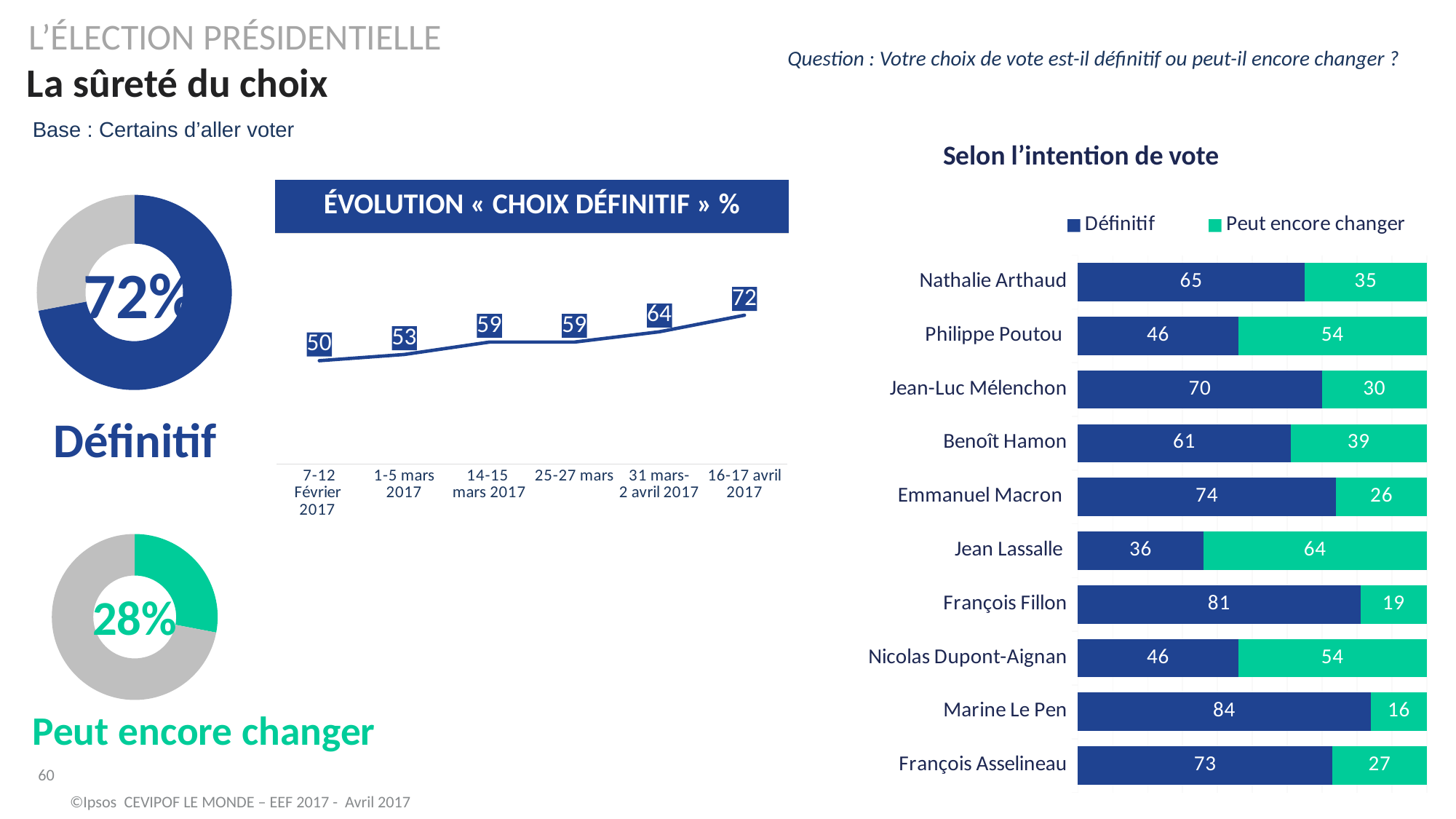
In the 'Selon l'intention de vote' chart, what is the difference between the 'Définitif' values for François Fillon and Benoît Hamon? 20 In the 'Selon l'intention de vote' chart, what is the 'Définitif' value for Marine Le Pen? 84 How many candidates are shown in the 'Selon l'intention de vote' chart? 10 In the 'ÉVOLUTION « CHOIX DÉFINITIF » %' chart, do the values rise or fall from 7-12 Février 2017 to 16-17 avril 2017? Rise In the 'Selon l'intention de vote' chart, which candidate has the lowest 'Définitif' value? Jean Lassalle In the 'Selon l'intention de vote' chart, what is the 'Peut encore changer' value for Jean Lassalle? 64 What percentage does the 'Définitif' donut chart on the left show? 72% In the 'Selon l'intention de vote' chart, which candidate has the highest 'Définitif' value? Marine Le Pen In the 'Selon l'intention de vote' chart, which is larger: the 'Définitif' value for Emmanuel Macron or for Jean-Luc Mélenchon? Emmanuel Macron How many series does the legend of the 'Selon l'intention de vote' chart list? 2 In the 'ÉVOLUTION « CHOIX DÉFINITIF » %' chart, what is the value for 31 mars-2 avril 2017? 64 What kind of chart is the 'Selon l'intention de vote' chart? Stacked bar chart